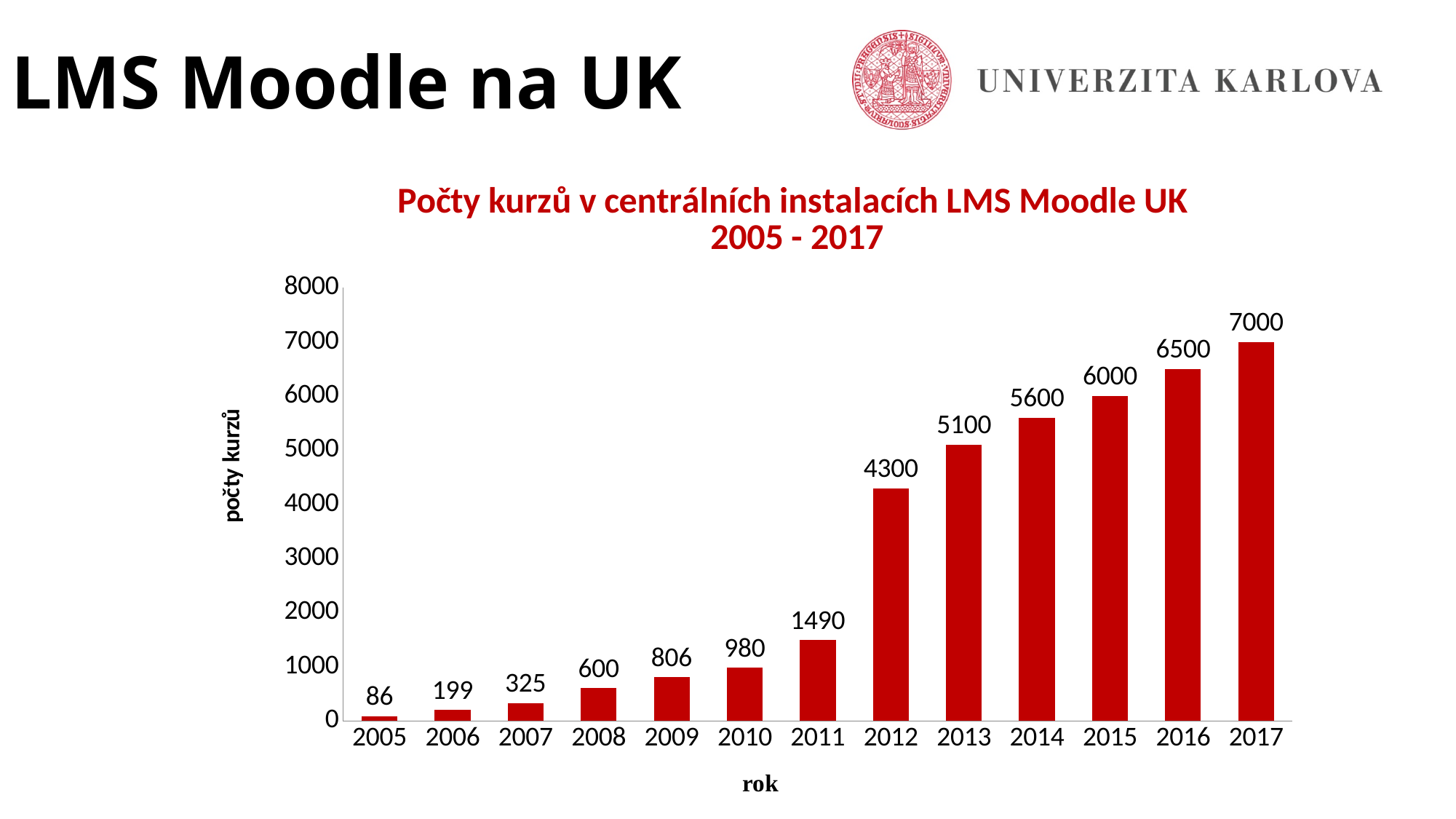
What is the difference between the values for 2012 and 2011? 2810 Which is larger, the value for 2010 or the value for 2013? 2013 What is the value for 2005? 86 What kind of chart is shown on the slide? bar chart Is the value for 2014 greater or less than 5000? greater Do the values rise or fall from 2005 to 2017? rise What is the number of courses shown for 2012? 4300 What is the difference between the values for 2017 and 2016? 500 Which year has the lowest number of courses? 2005 Which year has the highest number of courses? 2017 How many years are shown on the x axis? 13 What value is shown for 2009? 806